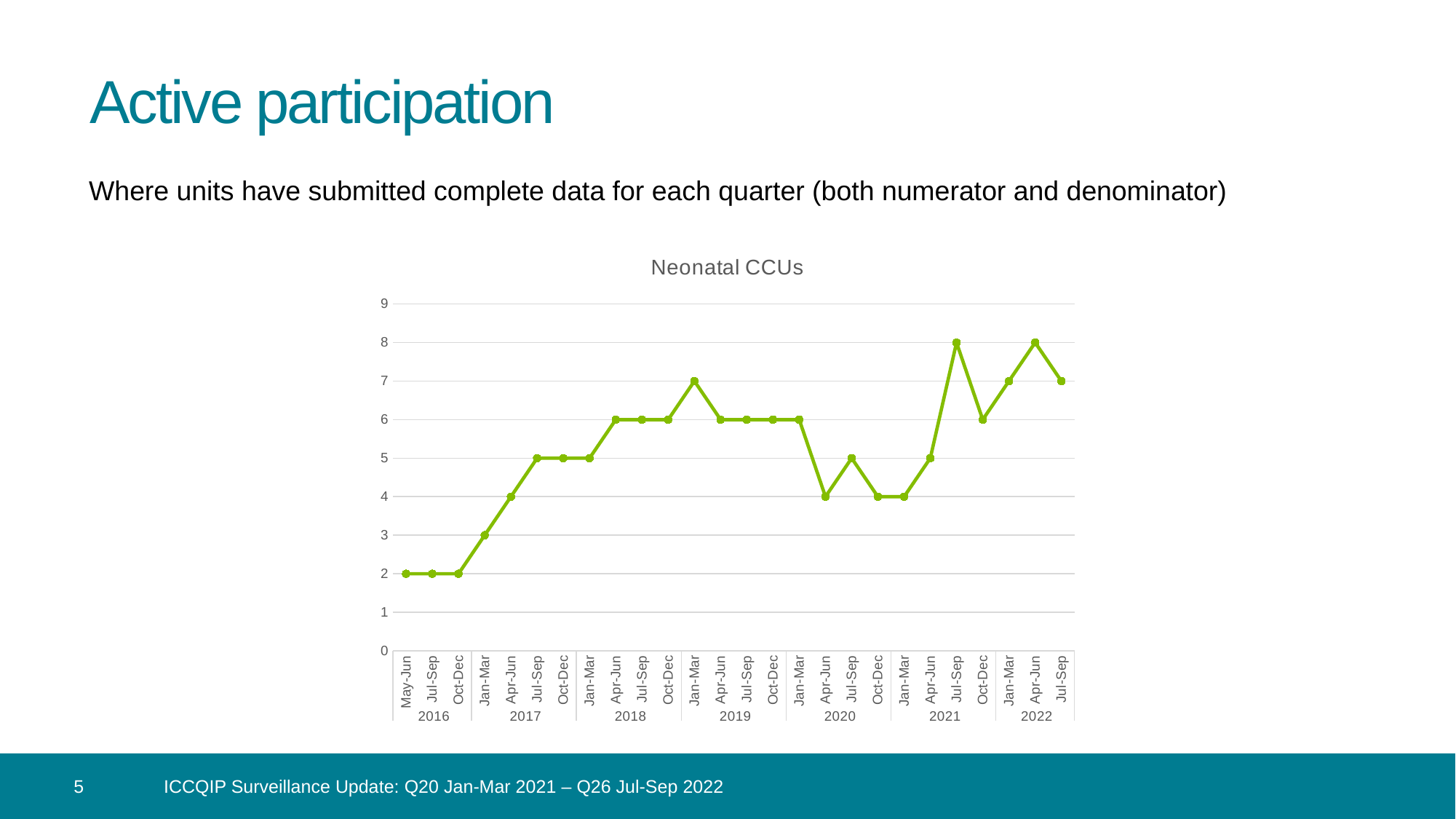
What is the lowest value shown on the chart? 2 How many data points are plotted on the chart? 26 What is the value for Jul-Sep 2021? 8 Do the values rise or fall from May-Jun 2016 to Jul-Sep 2017? rise What type of chart is shown on the slide? line chart What is the title of the chart? Neonatal CCUs What is the difference between the value for Jul-Sep 2021 and the value for Oct-Dec 2021? 2 Which is larger, the value for Apr-Jun 2020 or the value for Apr-Jun 2022? Apr-Jun 2022 What is the value for Jan-Mar 2019? 7 What is the value for May-Jun 2016? 2 What is the highest value reached on the chart? 8 What is the value for Jul-Sep 2022? 7